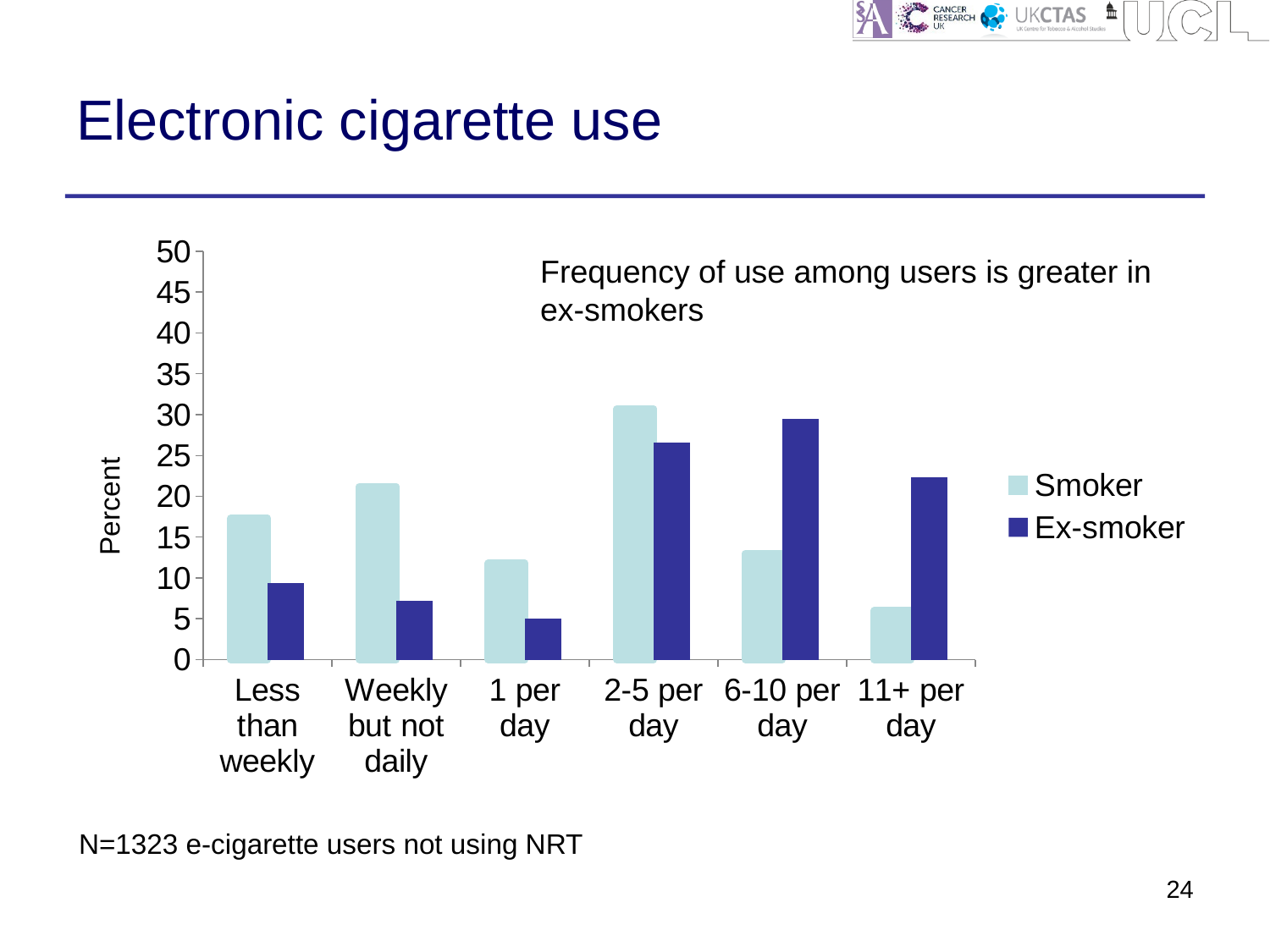
For the Ex-smoker series, which category has the highest value? 6-10 per day In the Less than weekly category, which is larger: Smoker or Ex-smoker? Smoker For the Smoker series, which category has the lowest value? 11+ per day In the 11+ per day category, which is larger: Smoker or Ex-smoker? Ex-smoker How many series does the legend list? 2 Is the Ex-smoker value for 1 per day greater or less than 10? less What is the sample size stated below the chart? N=1323 e-cigarette users not using NRT Is the Smoker value for 2-5 per day greater or less than 25? greater For the Smoker series, which category has the highest value? 2-5 per day What kind of chart is shown on the slide? Bar chart What is the label on the vertical axis? Percent How many frequency categories are shown on the x axis? 6